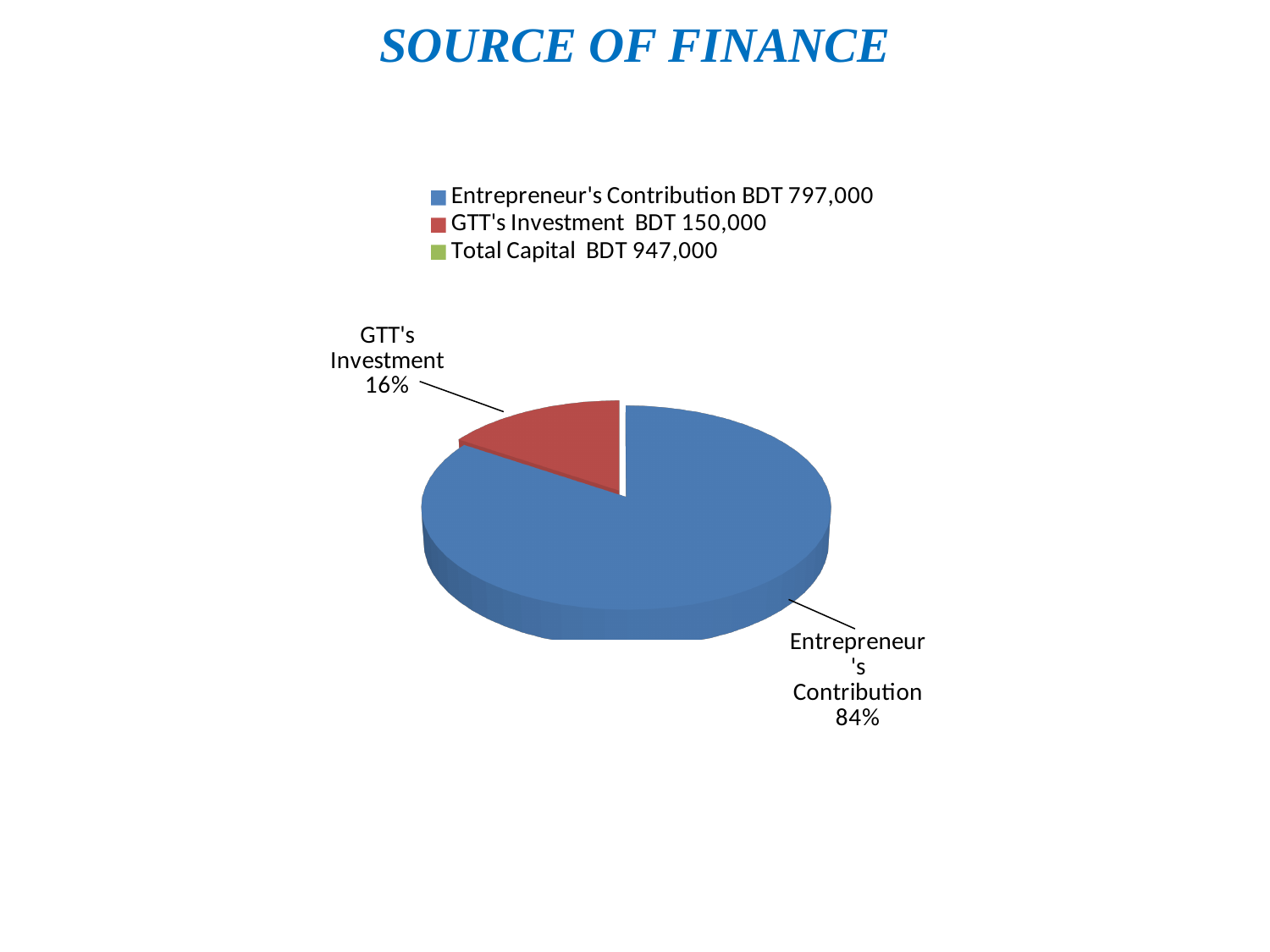
What is the difference in percentage points between the Entrepreneur's Contribution slice and the GTT's Investment slice? 68 According to the legend, what amount is given for Total Capital? BDT 947,000 Which slice of the pie is the largest? Entrepreneur's Contribution How many entries does the legend list? 3 What share of the pie does Entrepreneur's Contribution represent? 84% Which slice of the pie is the smallest? GTT's Investment What share of the pie does GTT's Investment represent? 16% What is the title of the slide above the chart? SOURCE OF FINANCE Which is larger, the Entrepreneur's Contribution slice or the GTT's Investment slice? Entrepreneur's Contribution How many slices are visible in the pie chart? 2 What kind of chart is shown on the slide? pie chart